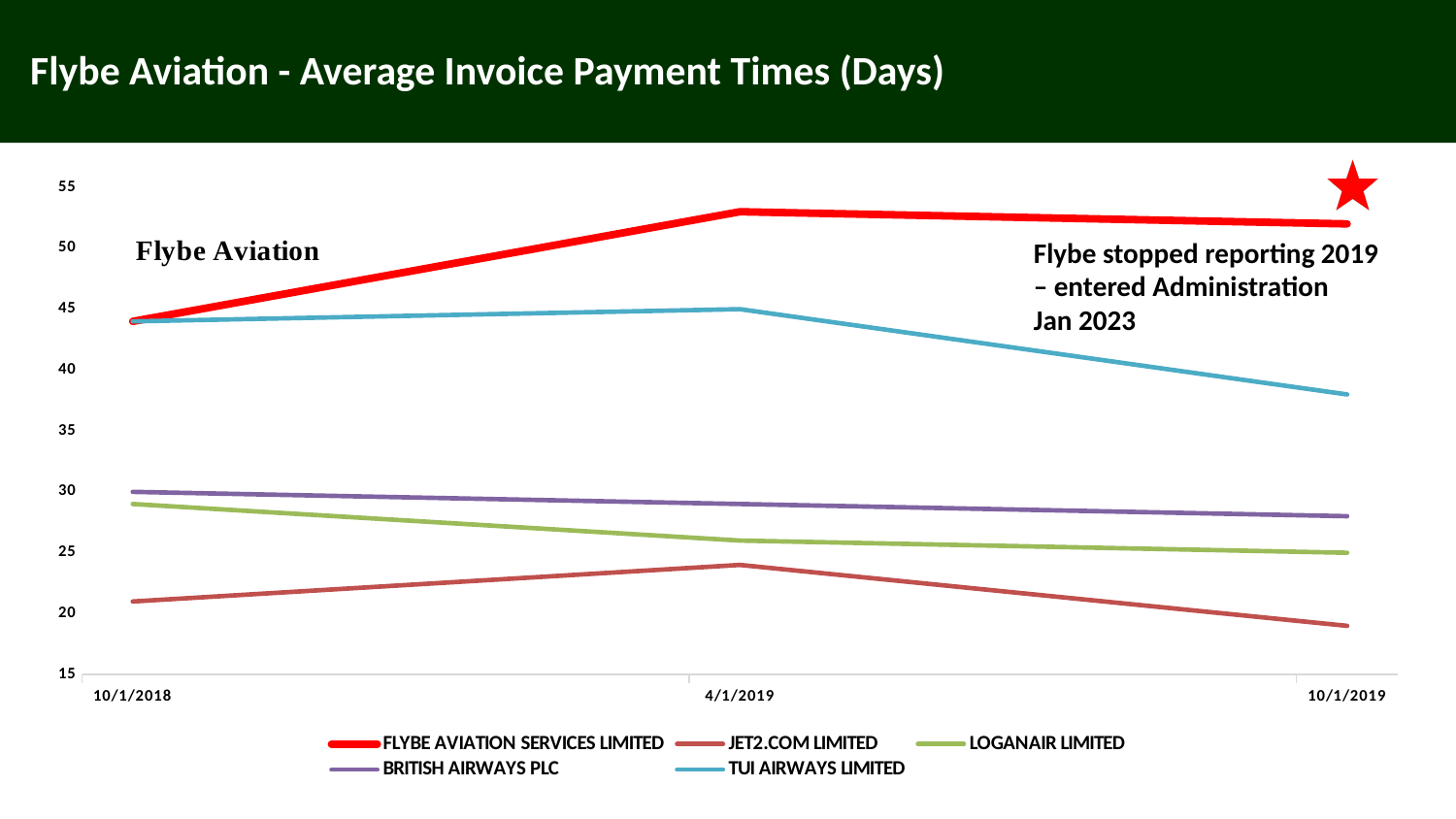
How many dates are shown on the x axis? 3 What is the title of the chart? Flybe Aviation - Average Invoice Payment Times (Days) At 4/1/2019, which is larger: TUI AIRWAYS LIMITED or BRITISH AIRWAYS PLC? TUI AIRWAYS LIMITED Is the value for TUI AIRWAYS LIMITED at 10/1/2019 greater or less than 40? less Which series has the highest value at 10/1/2019? FLYBE AVIATION SERVICES LIMITED Is the value for BRITISH AIRWAYS PLC at 10/1/2019 greater or less than 30? less Which series has the lowest value at 10/1/2019? JET2.COM LIMITED Does the TUI AIRWAYS LIMITED line rise or fall between 4/1/2019 and 10/1/2019? fall Is the value for FLYBE AVIATION SERVICES LIMITED at 4/1/2019 greater or less than 50? greater How many series does the legend list? 5 Does the FLYBE AVIATION SERVICES LIMITED line rise or fall between 10/1/2018 and 4/1/2019? rise What kind of chart is shown on the slide? Line chart